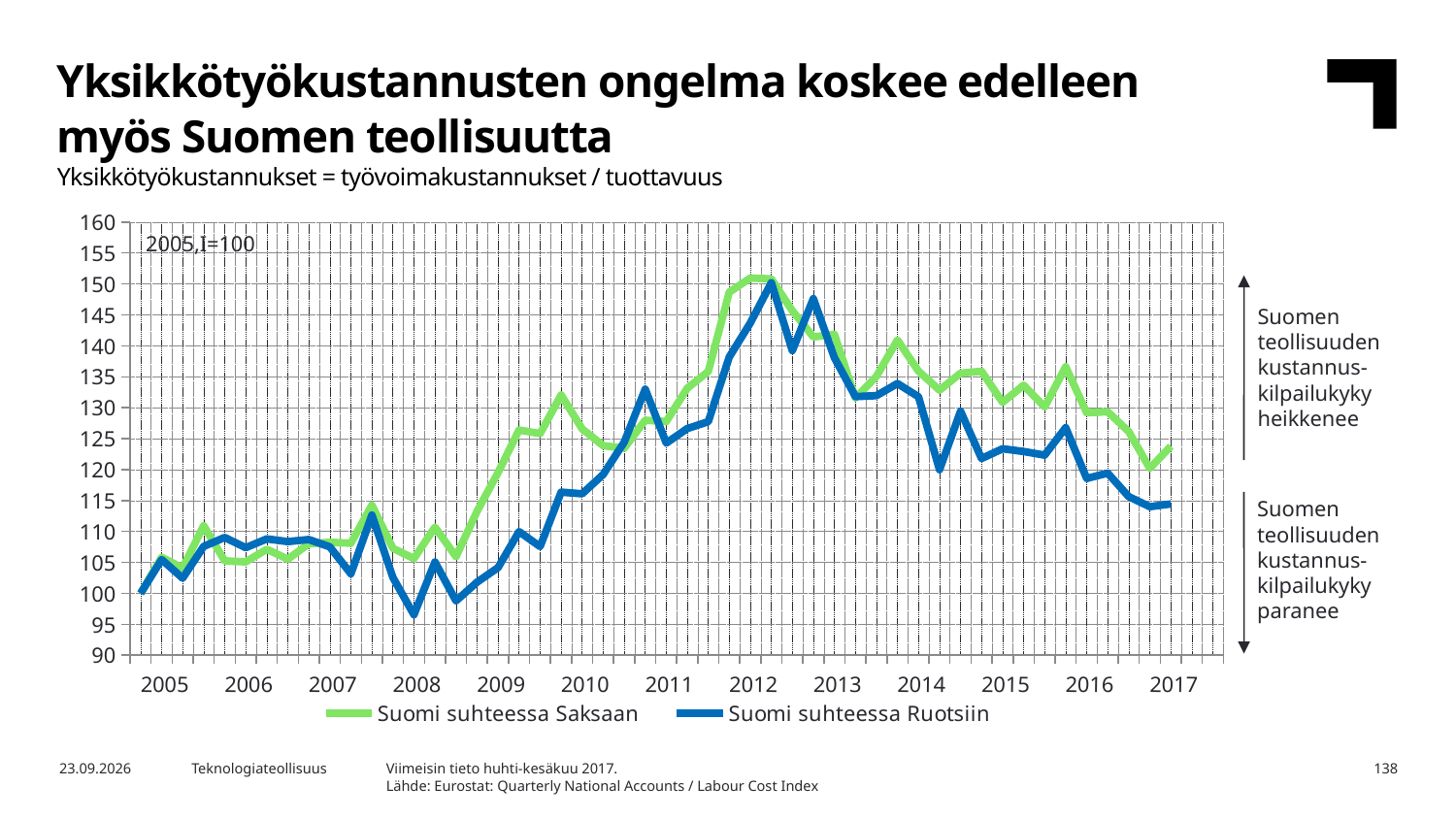
What are the two series named in the legend? Suomi suhteessa Saksaan; Suomi suhteessa Ruotsiin Is the value of 'Suomi suhteessa Saksaan' at the end of the series in 2017 greater or less than 120? greater What kind of chart is shown on the slide? Line chart Do both series rise or fall overall from their 2012 peak to 2017? Fall In which year does 'Suomi suhteessa Ruotsiin' reach its lowest value? 2008 How many series does the legend list? 2 In which year does 'Suomi suhteessa Saksaan' reach its highest value? 2012 At the end of the series in 2017, which line is higher: 'Suomi suhteessa Saksaan' or 'Suomi suhteessa Ruotsiin'? Suomi suhteessa Saksaan Is the value of 'Suomi suhteessa Ruotsiin' at the end of the series in 2017 greater or less than 120? less What colour is the line for 'Suomi suhteessa Ruotsiin'? Blue Is the lowest value of 'Suomi suhteessa Ruotsiin' in 2008 greater or less than 100? less What is the index value of both series at the start of 2005, according to the note on the chart? 100